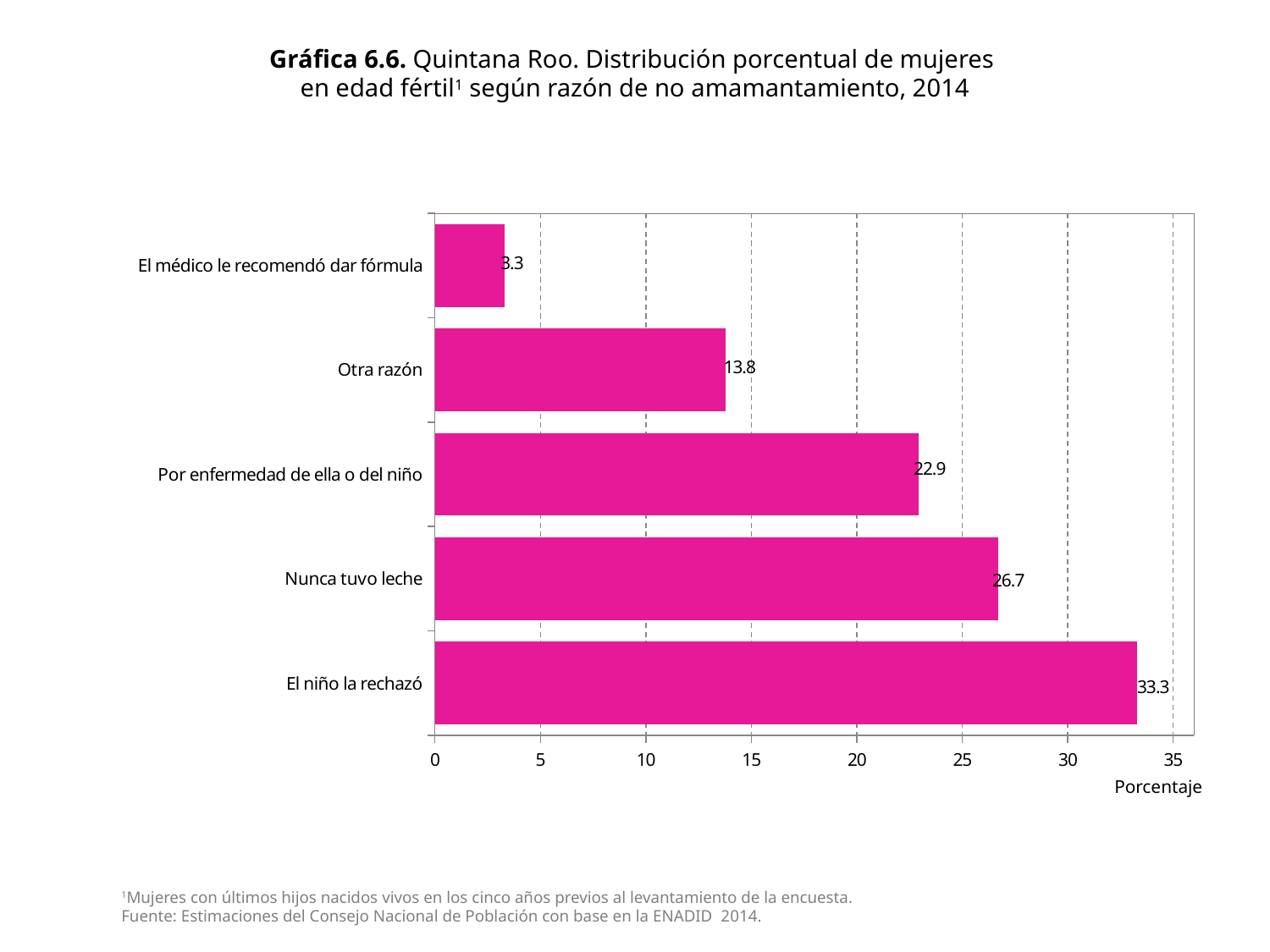
What is the label of the horizontal axis? Porcentaje What kind of chart is shown on the slide? Bar chart Which category has the lowest value? El médico le recomendó dar fórmula What is the value for "Otra razón"? 13.8 What is the value for "El niño la rechazó"? 33.3 Which is larger, the value for "Otra razón" or the value for "Por enfermedad de ella o del niño"? Por enfermedad de ella o del niño Which category has the highest value? El niño la rechazó What is the value for "Nunca tuvo leche"? 26.7 What is the value for "El médico le recomendó dar fórmula"? 3.3 How many categories are shown in the chart? 5 What is the value for "Por enfermedad de ella o del niño"? 22.9 What is the difference between the values for "El niño la rechazó" and "Nunca tuvo leche"? 6.6